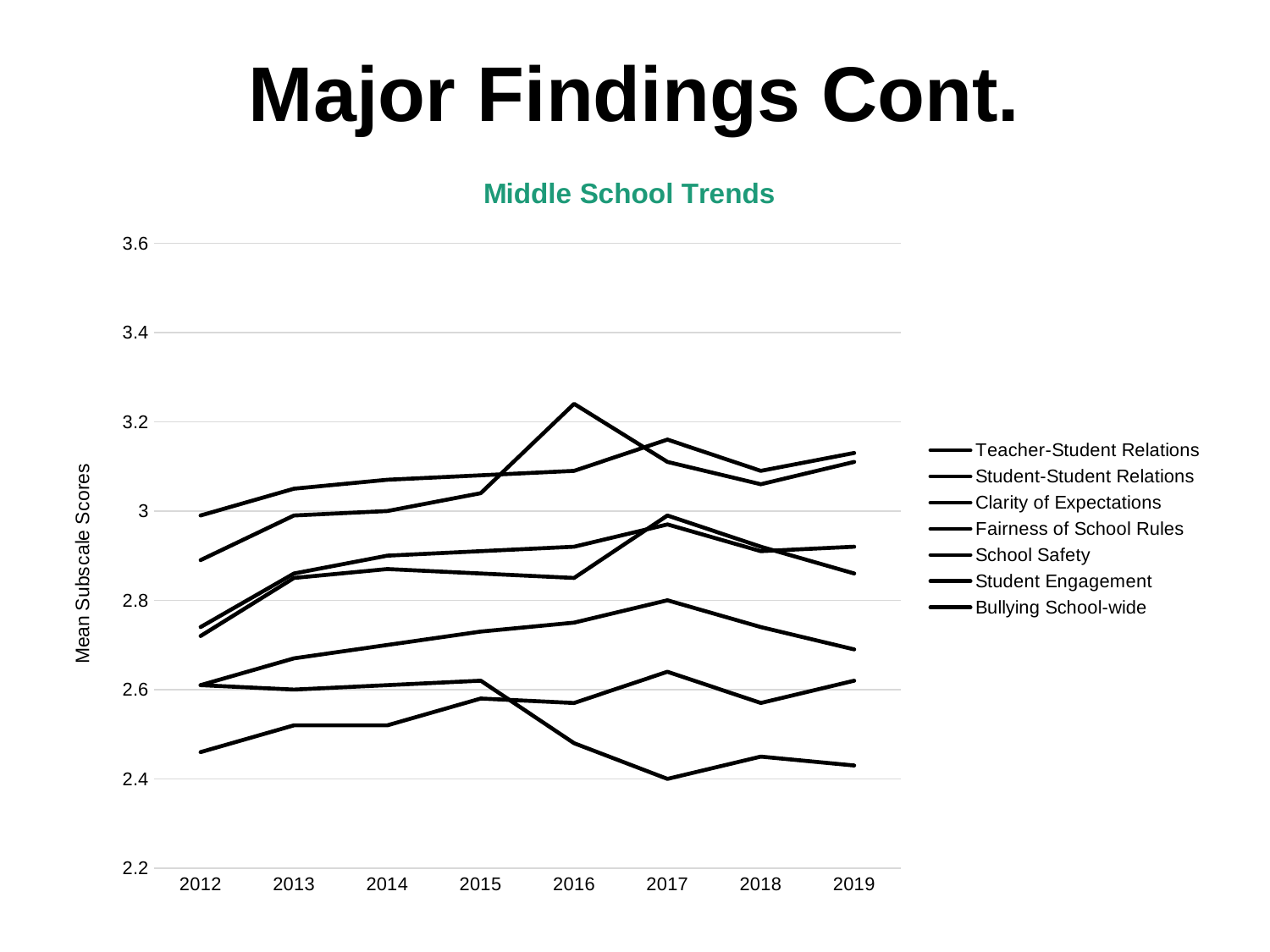
How many series does the legend list? 7 Is the highest plotted value on the chart greater or less than 3.4? less Is the lowest plotted value on the chart greater or less than 2.2? greater In which year does the lowest point on the chart occur? 2017 What is the label on the y axis? Mean Subscale Scores What kind of chart is shown on the slide? line chart In which year does the highest point on the chart occur? 2016 What is the title of the chart? Middle School Trends How many years are shown on the x axis? 8